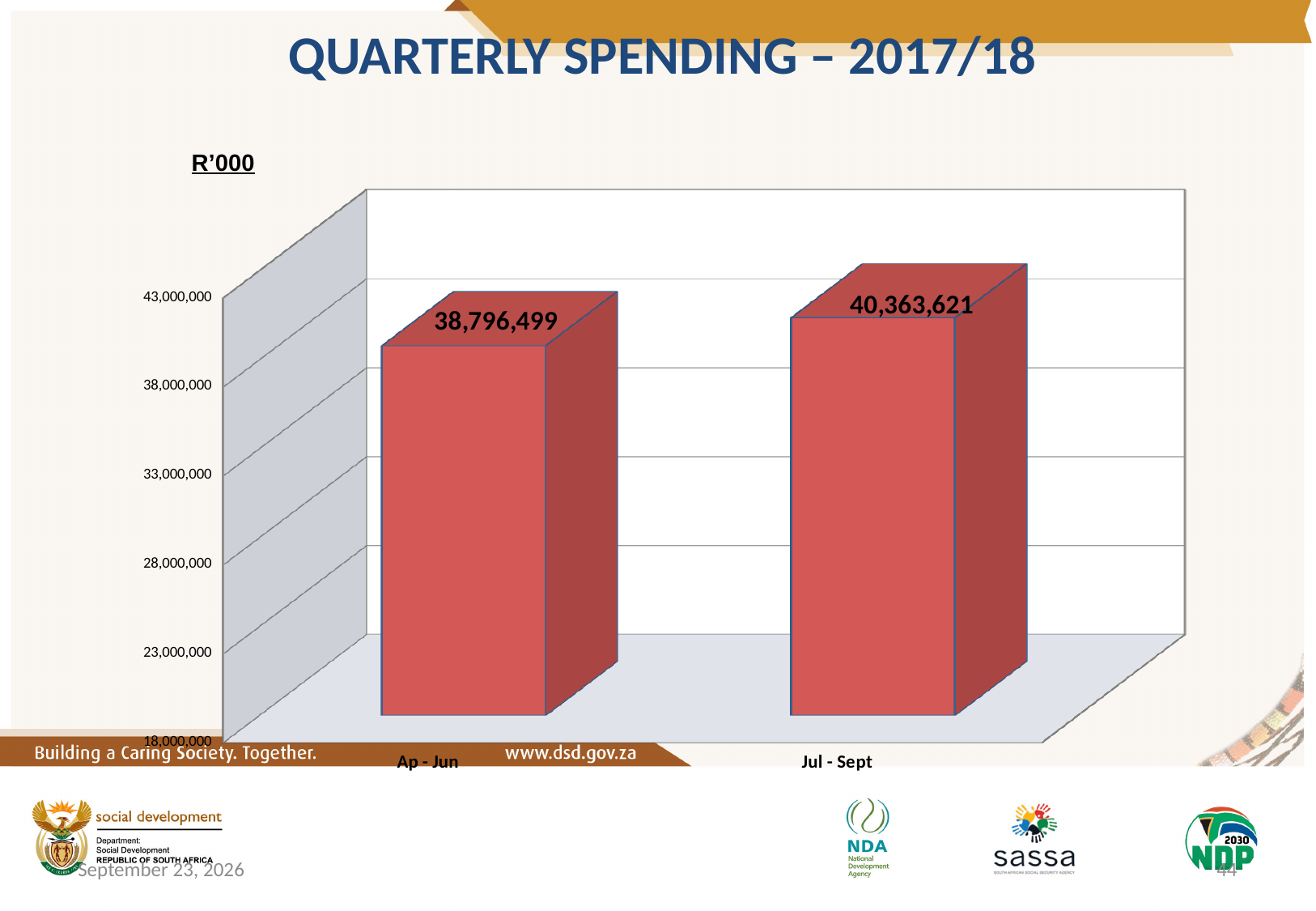
Is the value for Jul - Sept greater or less than 43,000,000? less What unit label is shown above the chart? R'000 Which quarter has the highest spending? Jul - Sept Do the values rise or fall from Ap - Jun to Jul - Sept? rise What is the value for Ap - Jun? 38,796,499 What is the value for Jul - Sept? 40,363,621 What is the difference between the Jul - Sept value and the Ap - Jun value? 1,567,122 Which is larger, the value for Ap - Jun or the value for Jul - Sept? Jul - Sept Is the value for Ap - Jun greater or less than 38,000,000? greater How many quarters are shown on the chart? 2 What kind of chart is shown on the slide? bar chart Which quarter has the lowest spending? Ap - Jun